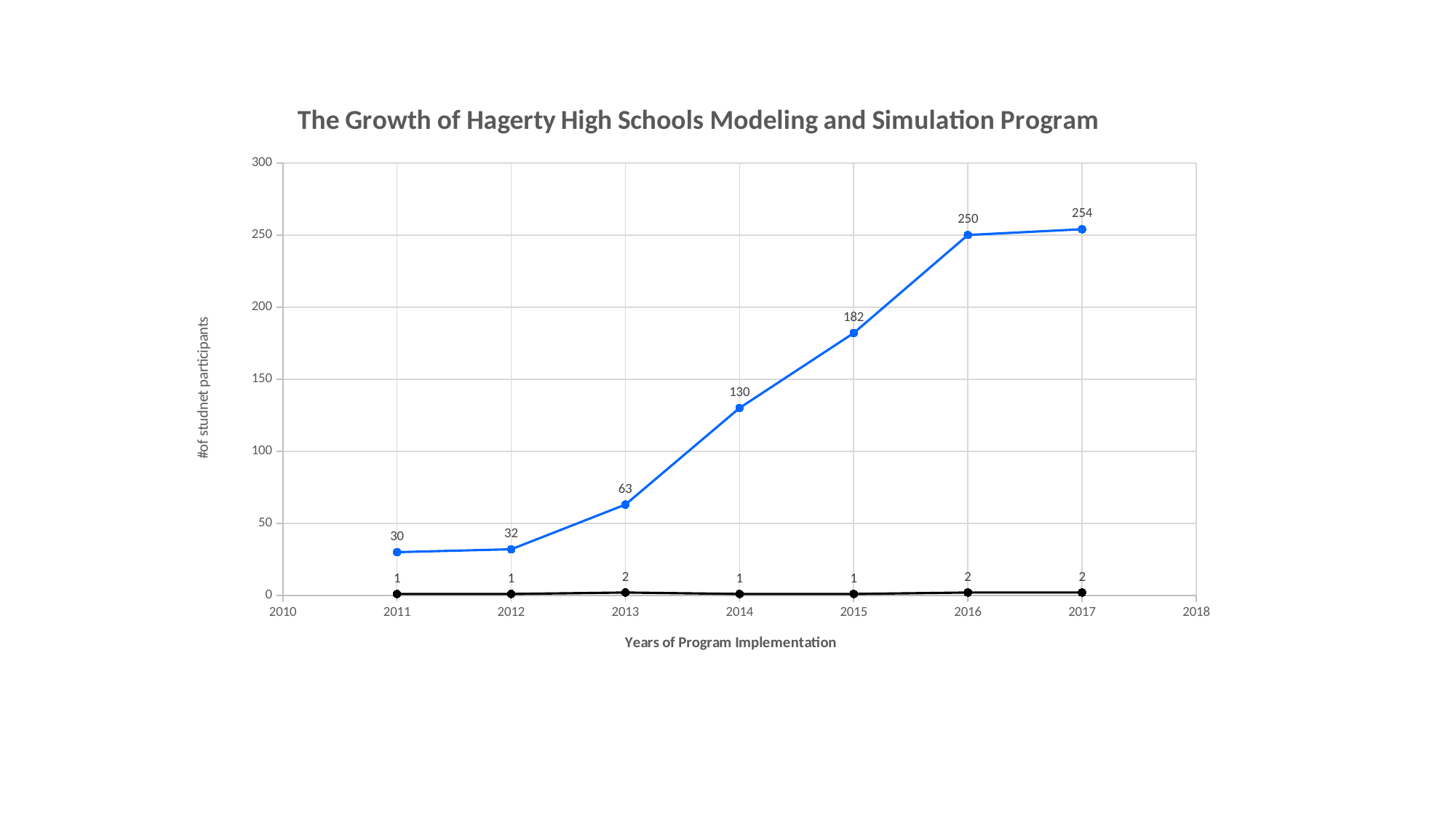
Does the blue line rise or fall from 2011 to 2017? rise What is the title of the chart? The Growth of Hagerty High Schools Modeling and Simulation Program In which year does the blue line have its lowest value? 2011 How many years have data points plotted on the chart? 7 In which year does the blue line reach its highest value? 2017 Which year has the larger blue-line value, 2013 or 2014? 2014 What kind of chart is shown on the slide? line chart What is the value of the black line in 2013? 2 What is the value of the blue line in 2014? 130 What is the value of the blue line in 2011? 30 What is the difference between the blue line's values in 2016 and 2015? 68 Is the blue line's value in 2015 greater or less than 200? less